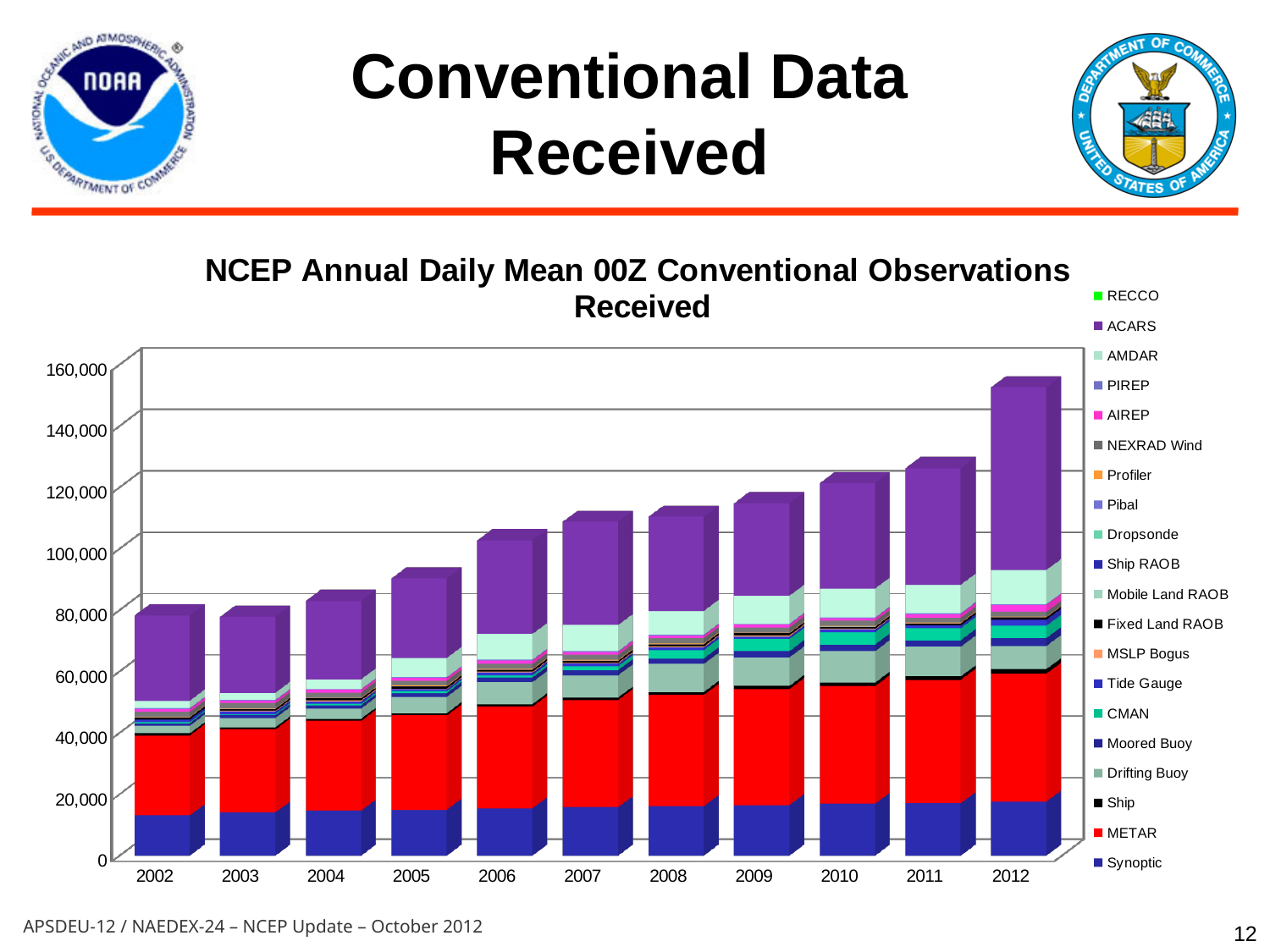
How many series does the chart's legend list? 20 What kind of chart is shown on the slide? Stacked bar chart Do the total observations received generally rise or fall from 2002 to 2012? Rise Which year has the larger total, 2009 or 2005? 2009 Is the total for 2011 greater or less than 120,000? greater How many years are shown along the x axis of the chart? 11 Is the total for 2012 greater or less than 140,000? greater Which series is shown in red in the chart? METAR Is the total for 2007 greater or less than 100,000? greater What is the title of the chart? NCEP Annual Daily Mean 00Z Conventional Observations Received Which year has the highest total of conventional observations received? 2012